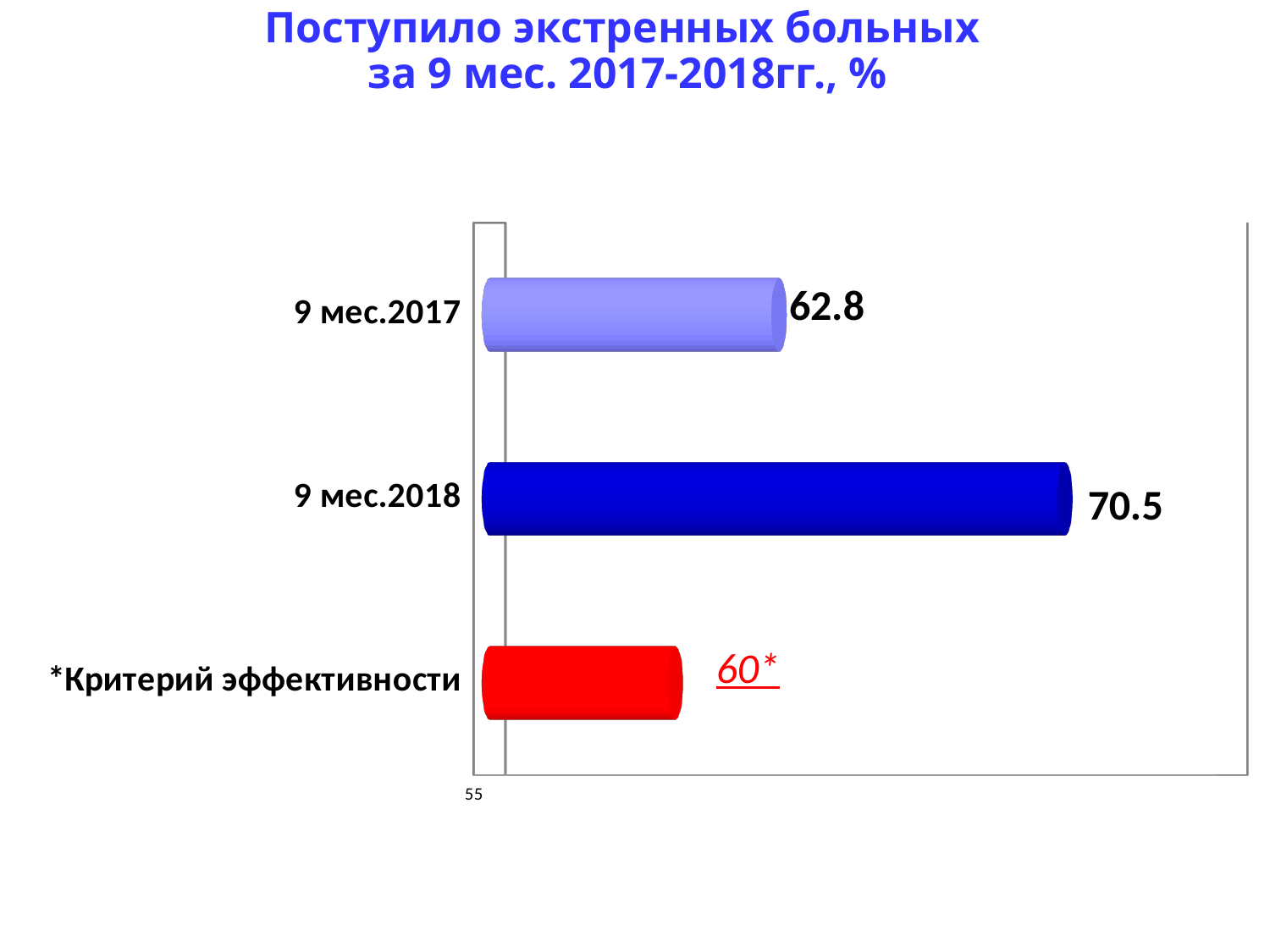
What is the difference between the values for 9 мес.2018 and 9 мес.2017? 7.7 What is the value for 9 мес.2018? 70.5 What is the value for 9 мес.2017? 62.8 Which category has the highest value? 9 мес.2018 How many bars are shown in the chart? 3 What kind of chart is shown on the slide? bar chart What value is shown for *Критерий эффективности? 60* Which category has the lowest value? *Критерий эффективности What colour is the bar for *Критерий эффективности? red Which is larger, the value for 9 мес.2017 or the value for 9 мес.2018? 9 мес.2018 What is the title of the chart? Поступило экстренных больных за 9 мес. 2017-2018гг., % By how much does the value for 9 мес.2018 exceed the *Критерий эффективности value of 60? 10.5